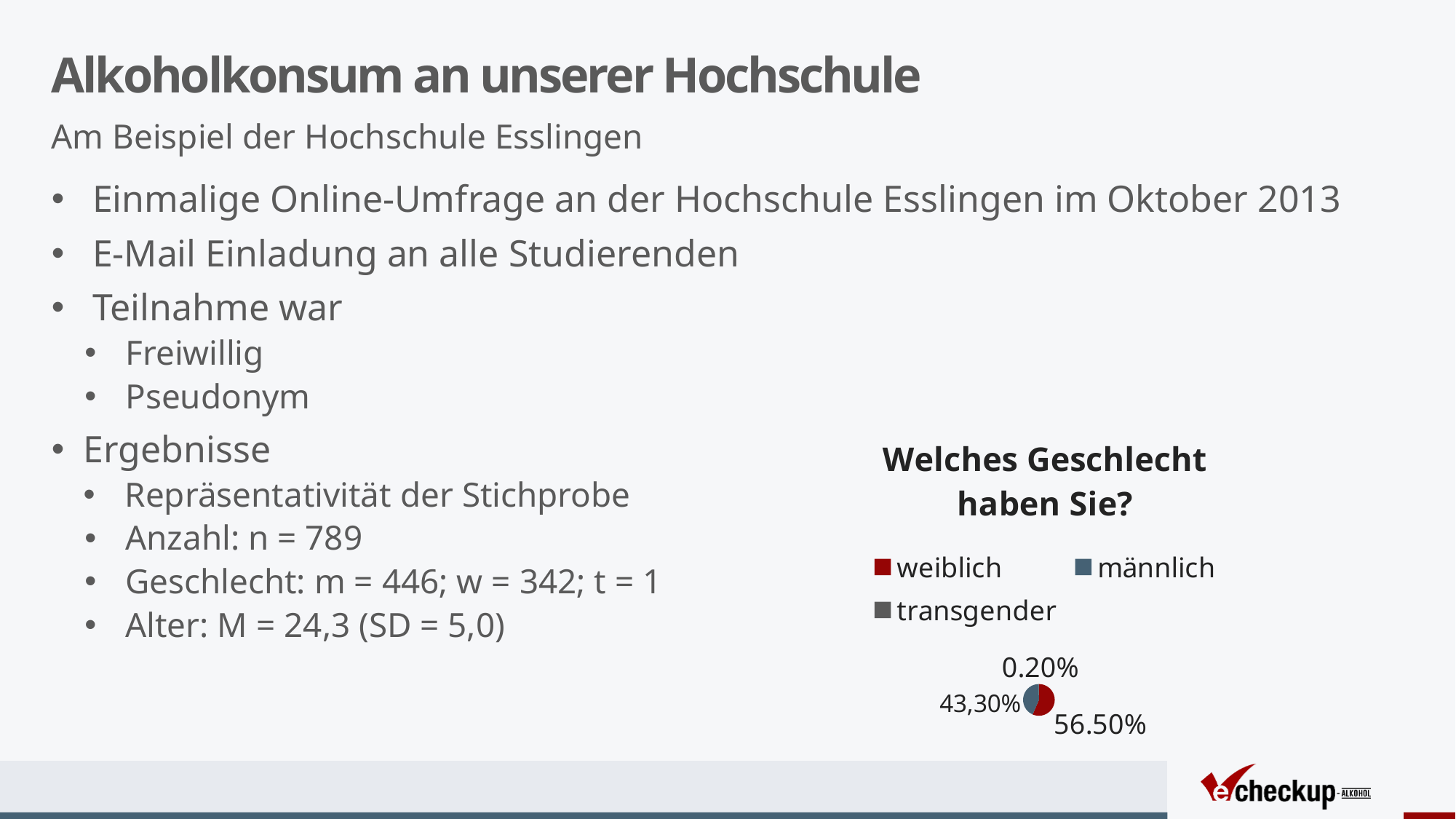
Is the share for transgender in the pie chart greater or less than 1%? less Which categories are listed in the legend of the pie chart? weiblich, männlich, transgender In the pie chart, what share is labelled for transgender? 0.20% What is the title of the pie chart on the slide? Welches Geschlecht haben Sie? In the pie chart, what share is labelled for männlich? 43,30% What colour represents weiblich in the pie chart? red Which category has the largest slice in the pie chart? weiblich What kind of chart is shown under the title "Welches Geschlecht haben Sie?"? pie chart In the pie chart, which slice is larger: weiblich or männlich? weiblich Which category has the smallest slice in the pie chart? transgender How many categories does the legend of the pie chart list? 3 In the pie chart, what share is labelled for weiblich? 56.50%